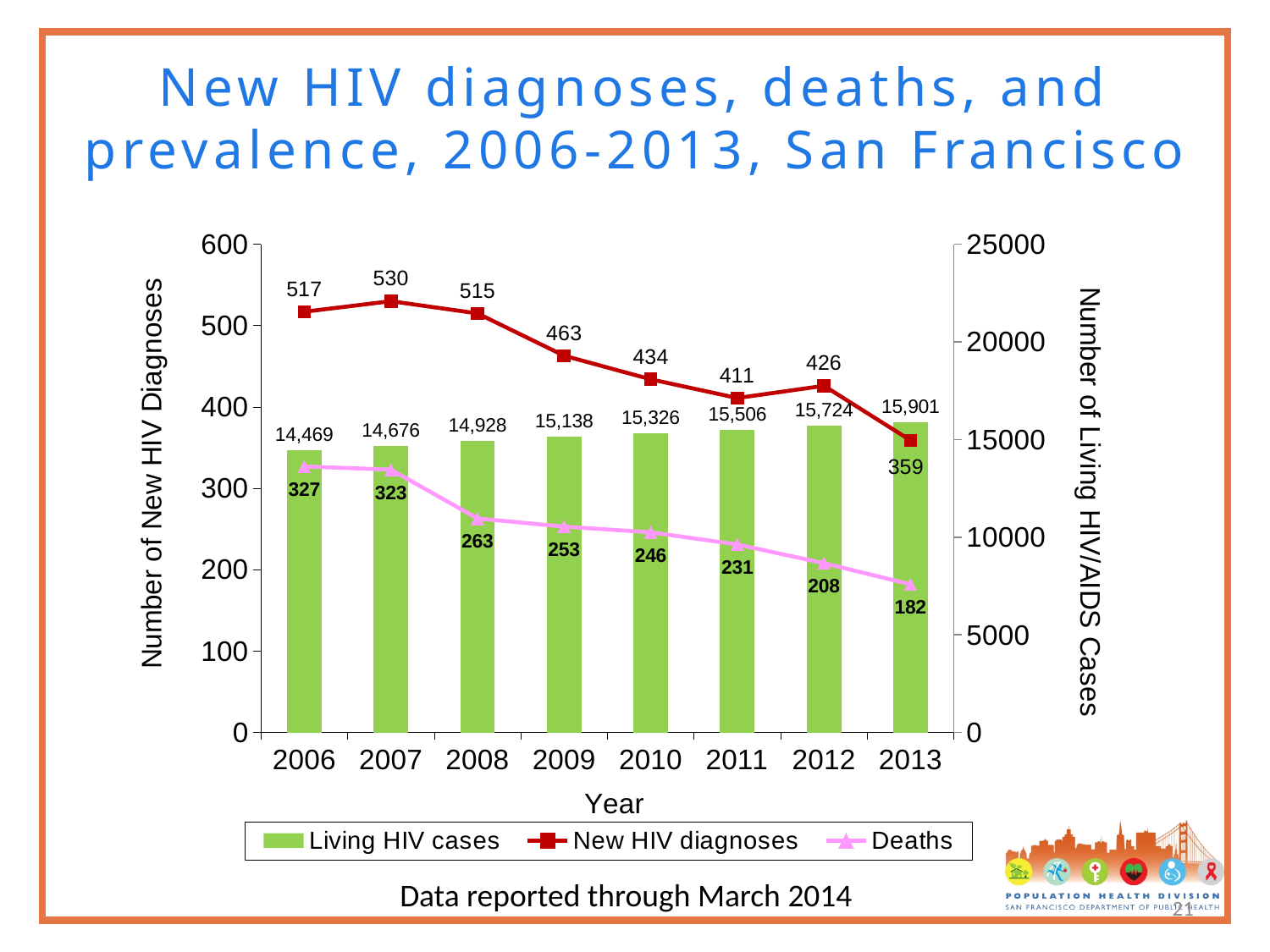
How many series does the legend list? 3 In which year were deaths highest? 2006 Which series is shown as green bars? Living HIV cases How many living HIV cases were there in 2013? 15,901 Do living HIV cases rise or fall from 2006 to 2013? Rise Which was larger in 2012: new HIV diagnoses or deaths? New HIV diagnoses How many years are shown on the x axis? 8 How many deaths were recorded in 2010? 246 What is the label of the right-hand y axis? Number of Living HIV/AIDS Cases In which year were new HIV diagnoses lowest? 2013 How many new HIV diagnoses were there in 2007? 530 What is the difference in new HIV diagnoses between 2006 and 2013? 158